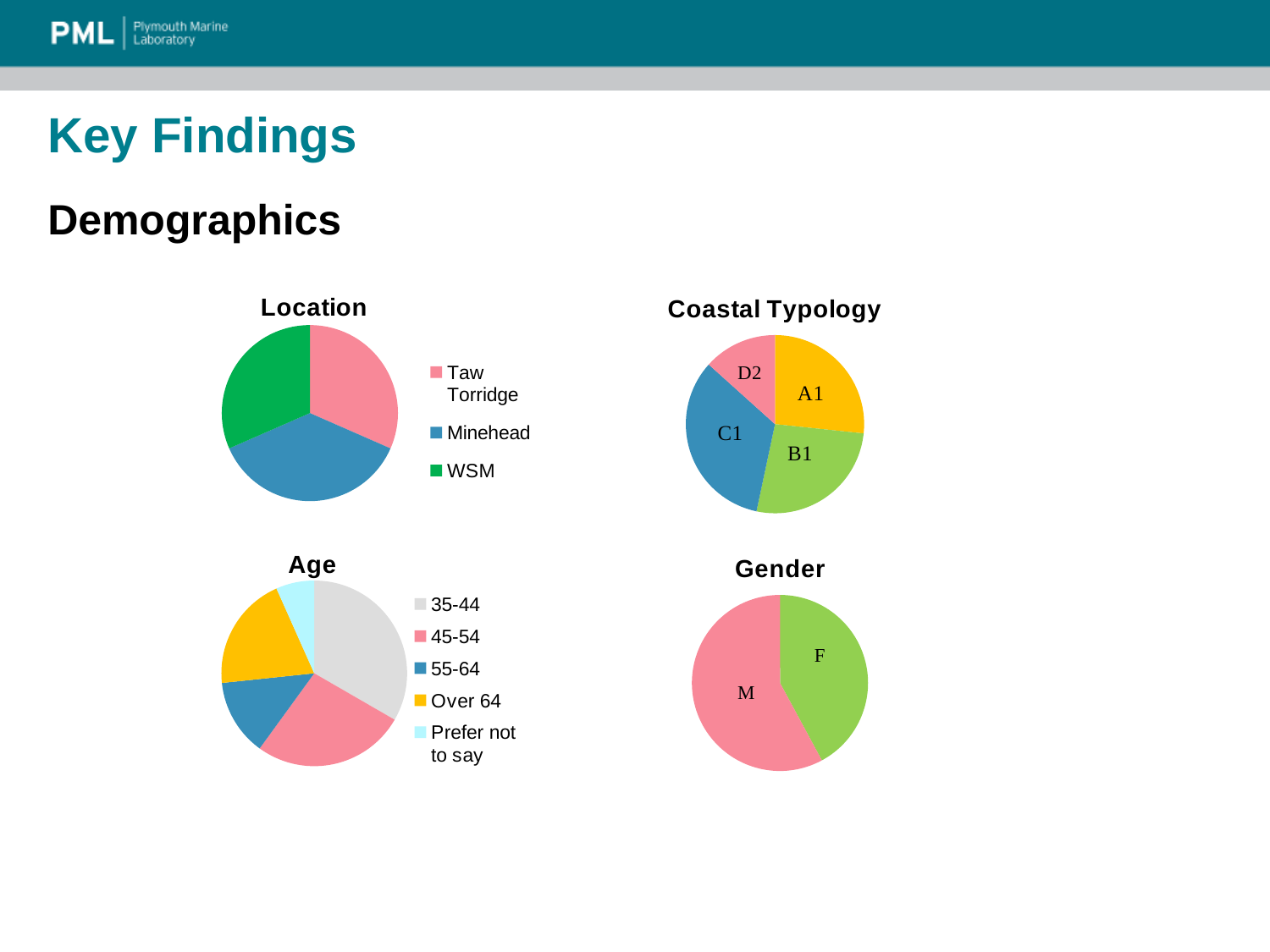
How many slices does the Coastal Typology chart have? 4 What is the title of the chart in the bottom right of the slide? Gender How many categories does the Location chart's legend list? 3 In the Gender chart, which slice is larger, M or F? M In the Age chart, which is larger, the 45-54 slice or the 55-64 slice? 45-54 In the Age chart, which category has the smallest slice? Prefer not to say In the Location chart, which colour represents WSM? Green In the Coastal Typology chart, which category has the smallest slice? D2 How many pie charts are shown on the slide? 4 How many age groups are shown in the Age chart? 5 In the Age chart, which age group has the largest slice? 35-44 What kind of chart is the Location chart? Pie chart